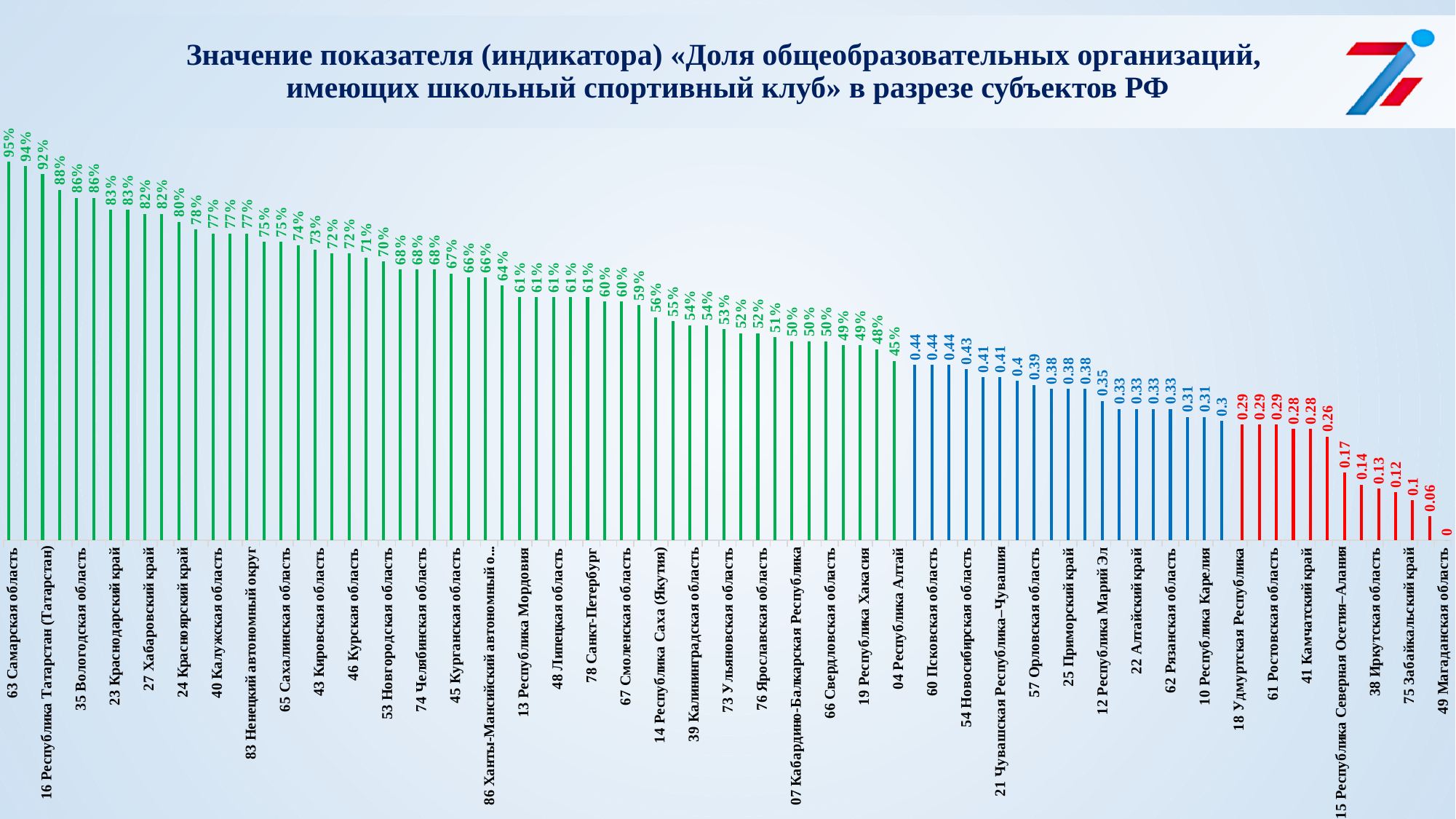
What is the value shown for 63 Самарская область? 95% Which has a larger value, 63 Самарская область or 49 Магаданская область? 63 Самарская область Which region has the highest value on the chart? 63 Самарская область What is the difference between the values for 63 Самарская область and 16 Республика Татарстан? 3% Which region has the lowest value on the chart? 49 Магаданская область What is the value shown for 04 Республика Алтай? 45% What is the value shown for 49 Магаданская область? 0 Do the values rise or fall from left to right along the x axis? Fall What kind of chart is shown on the slide? Bar chart What is the value shown for 16 Республика Татарстан (Татарстан)? 92% What is the value shown for 78 Санкт-Петербург? 61% What colour are the bars with the lowest values at the right end of the chart? Red